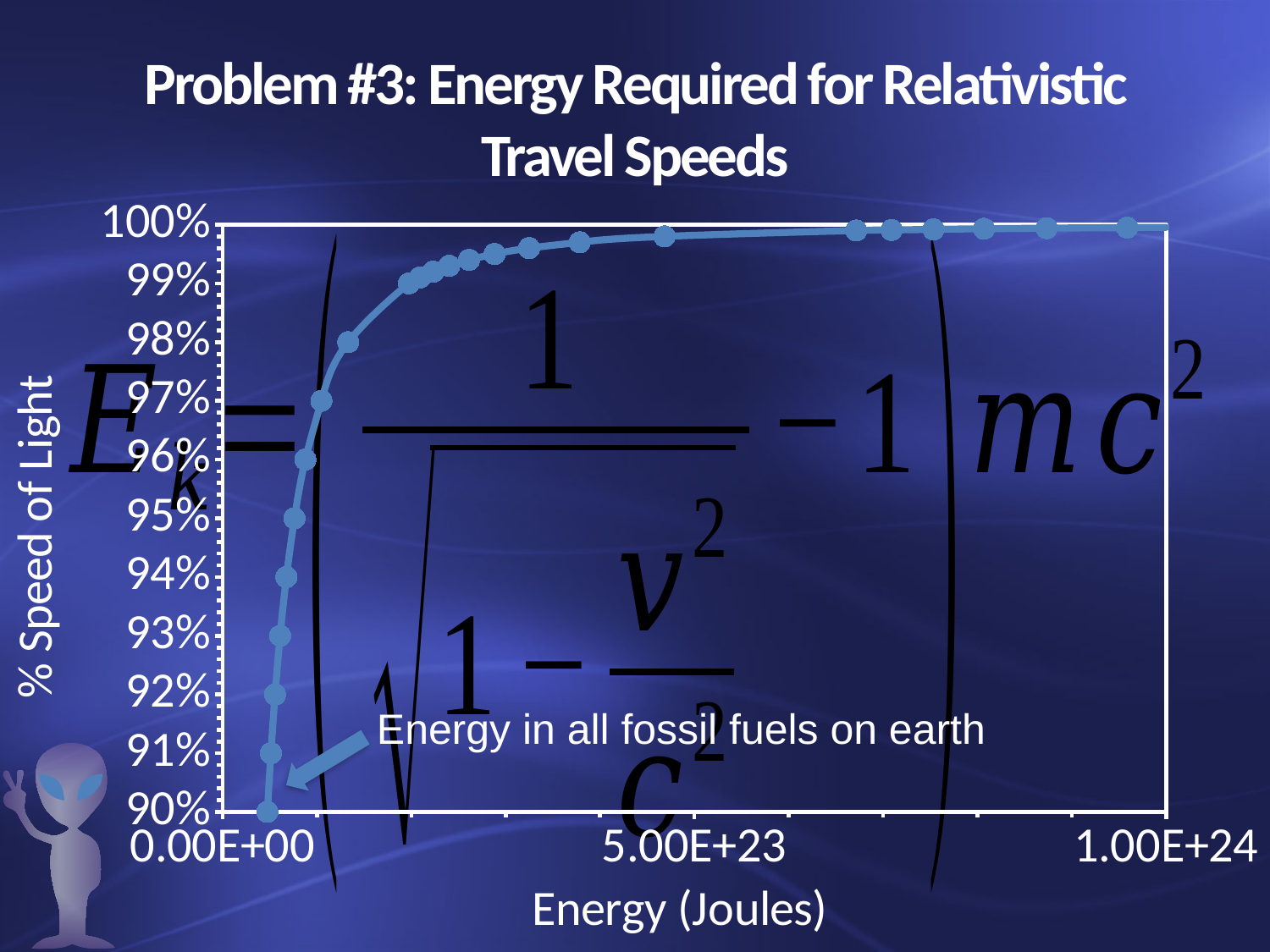
Is the lowest plotted value greater or less than 91%? less Is the value at 5.00E+23 joules greater or less than 98%? greater Which is larger, the value at 5.00E+23 joules or the value at the lowest energy shown? 5.00E+23 joules Do the plotted values rise or fall as energy increases along the x axis? rise Is the value at 5.00E+23 joules greater or less than 100%? less What is the title of the y axis? % Speed of Light What is the title of the x axis? Energy (Joules) What kind of chart is shown on the slide? line chart